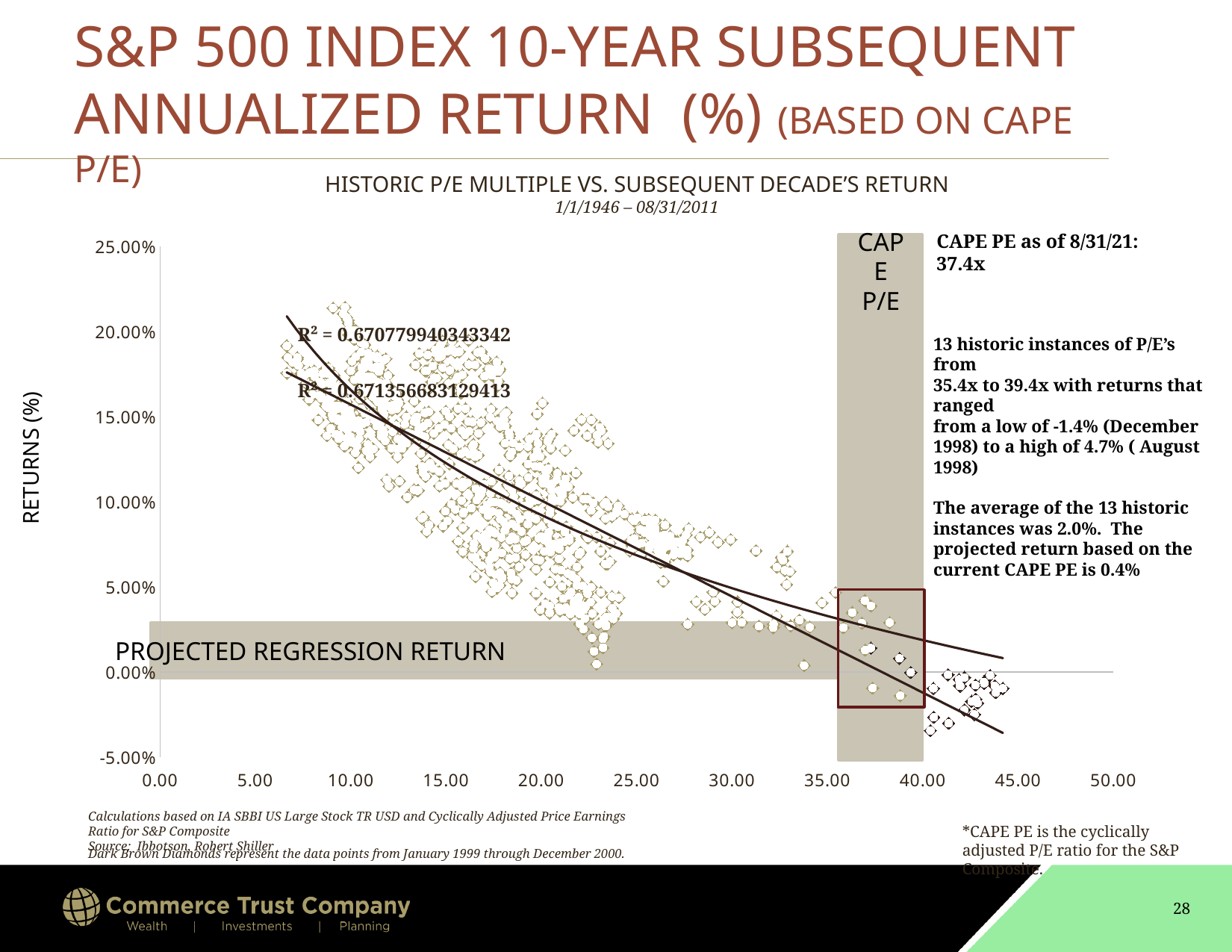
According to the annotation, what was the average return of the 13 historic instances of P/E's from 35.4x to 39.4x? 2.0% What R² value is printed for the upper (first) trend line on the chart? R² = 0.670779940343342 What kind of chart is shown on the slide? Scatter chart What is the lowest value shown on the chart's y axis? -5.00% According to the annotation on the chart, what is the CAPE PE as of 8/31/21? 37.4x What R² value is printed for the lower (second) trend line on the chart? R² = 0.671356683129413 What is the highest value shown on the chart's x axis? 50.00 What is the highest value shown on the chart's y axis? 25.00% What date range does the chart subtitle give for the data? 1/1/1946 – 08/31/2011 What is the title of the chart? HISTORIC P/E MULTIPLE VS. SUBSEQUENT DECADE'S RETURN According to the annotation on the chart, what is the projected return based on the current CAPE PE? 0.4% As the P/E multiple increases along the x axis, do the subsequent 10-year returns generally rise or fall? Fall